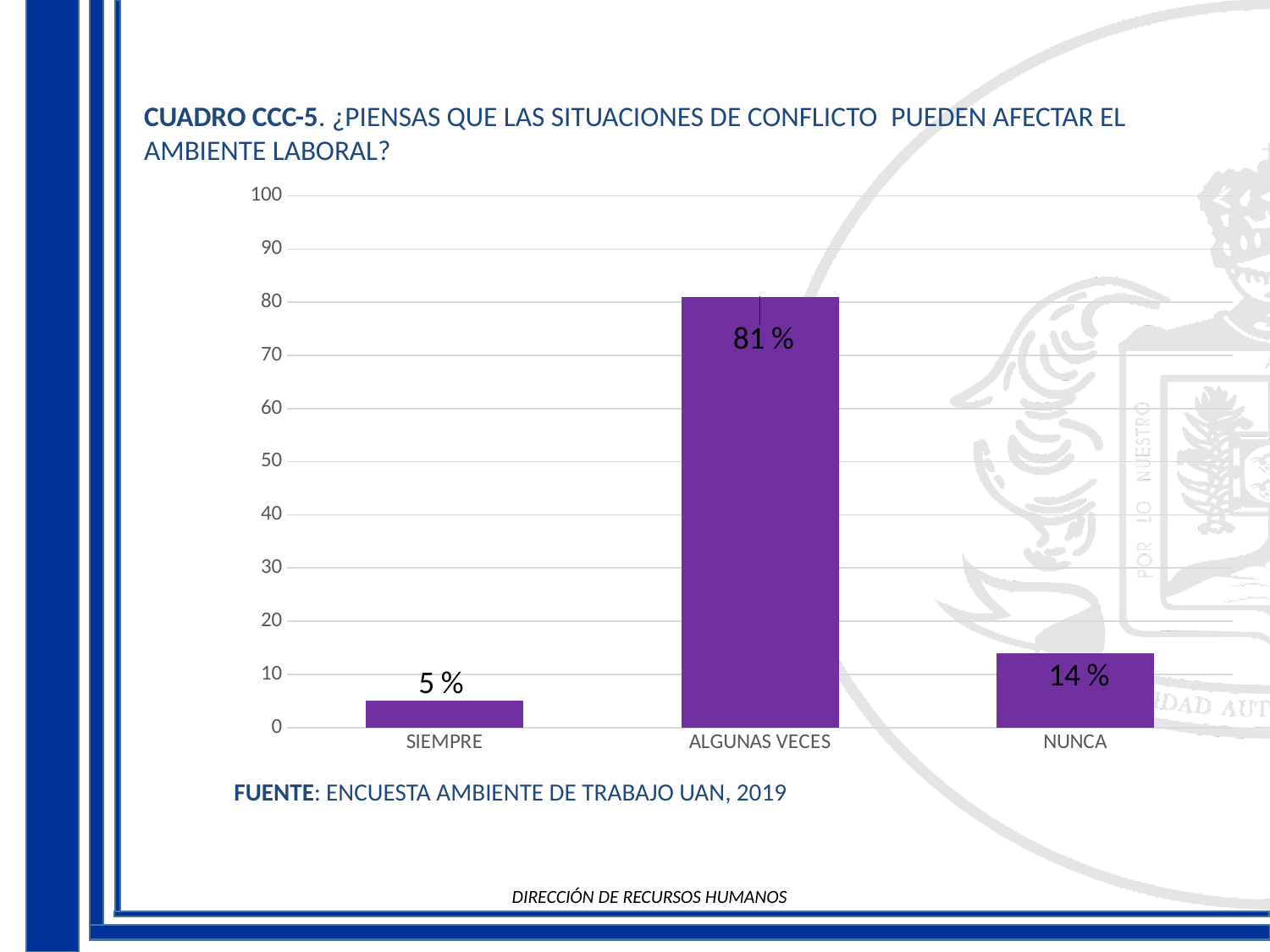
What source is cited below the chart? ENCUESTA AMBIENTE DE TRABAJO UAN, 2019 What is the value for NUNCA? 14 % Which category has the lowest value? SIEMPRE Is the value for ALGUNAS VECES greater or less than 50? greater What is the value for ALGUNAS VECES? 81 % Which is larger, the value for NUNCA or the value for SIEMPRE? NUNCA What is the value for SIEMPRE? 5 % What is the difference between the values for ALGUNAS VECES and NUNCA? 67 % What kind of chart is shown on the slide? bar chart Which category has the highest value? ALGUNAS VECES What is the difference between the values for NUNCA and SIEMPRE? 9 % How many categories are shown on the x axis? 3